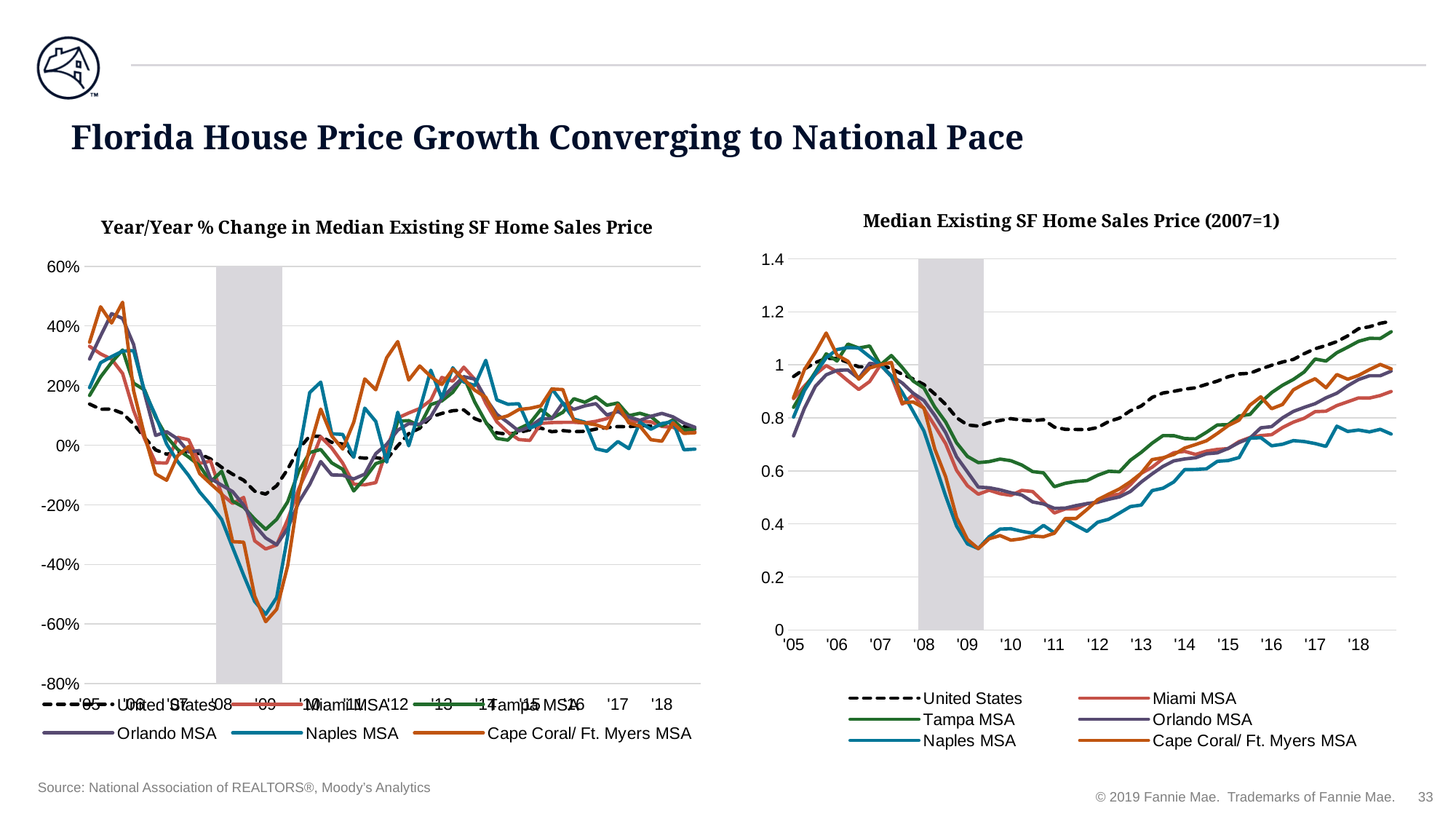
How many series does the legend of the right chart, 'Median Existing SF Home Sales Price (2007=1)', list? 6 In the right chart, which is higher in '18: United States or Naples MSA? United States In the left chart, does the United States line ever fall below -20%? No In the right chart, which series is drawn as a dashed black line? United States In the right chart, does the United States line rise or fall from '12 to '18? Rise In the left chart, is the lowest value for Cape Coral/ Ft. Myers MSA (around '09) greater or less than -40%? less What is the title of the right chart? Median Existing SF Home Sales Price (2007=1) In the right chart, is the value for United States in '18 greater or less than 1? greater How many year labels are shown on the x axis of the right chart? 14 What kind of chart is the left chart, 'Year/Year % Change in Median Existing SF Home Sales Price'? Line chart